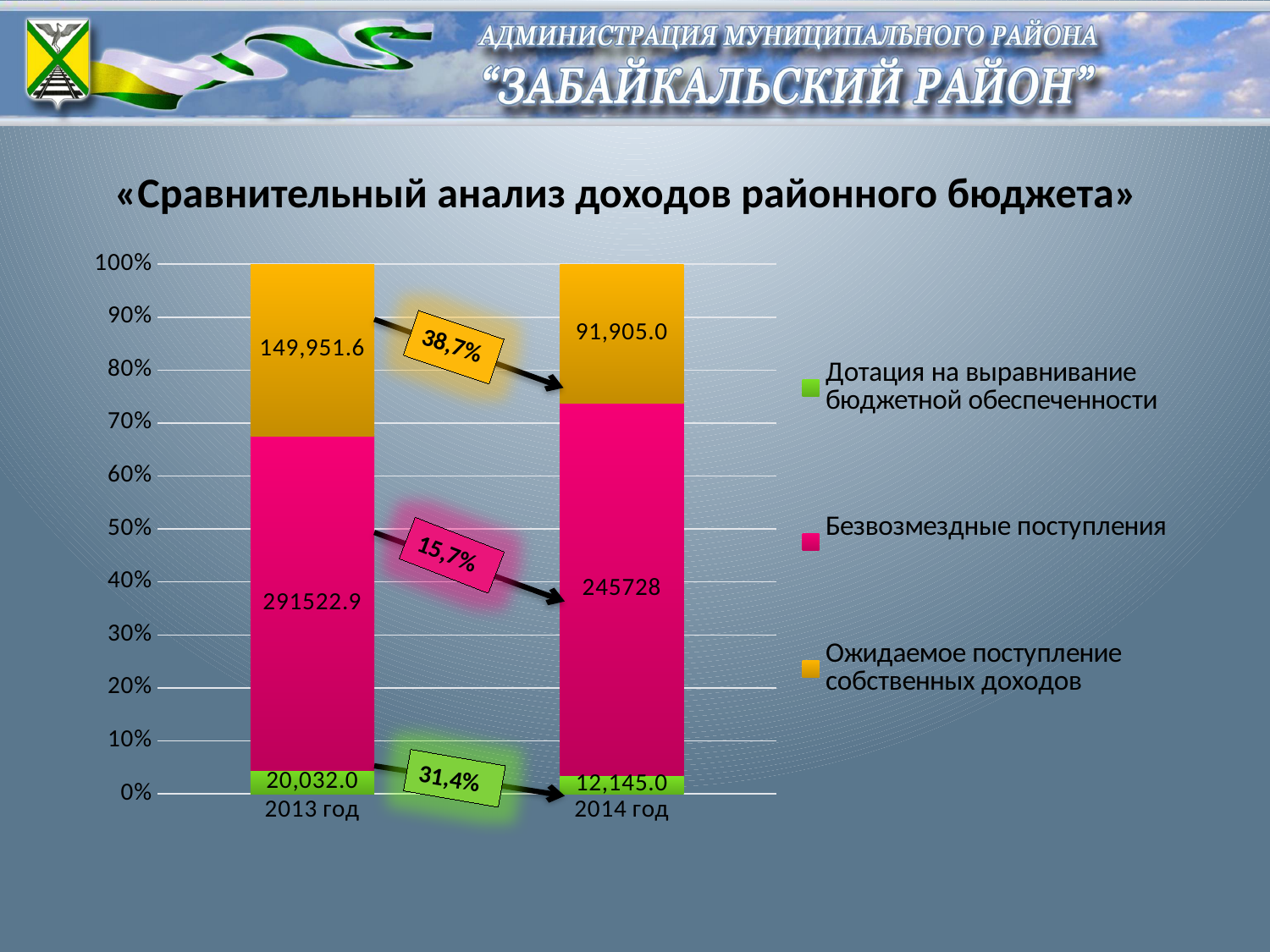
How many series does the legend list? 3 What is the value of «Ожидаемое поступление собственных доходов» for 2014 год? 91,905.0 What is the value of «Безвозмездные поступления» for 2014 год? 245728 What is the difference between the «Дотация на выравнивание бюджетной обеспеченности» values for 2013 год and 2014 год? 7,887.0 How many categories (years) are shown on the x axis? 2 What type of chart is shown on the slide? stacked bar chart What percentage change is shown on the arrow between the «Ожидаемое поступление собственных доходов» segments? 38,7% Which series has the largest value in 2013 год? Безвозмездные поступления Which series has the smallest value in 2014 год? Дотация на выравнивание бюджетной обеспеченности What is the value of «Ожидаемое поступление собственных доходов» for 2013 год? 149,951.6 Is the value of «Безвозмездные поступления» larger in 2013 год or 2014 год? 2013 год What is the value of «Дотация на выравнивание бюджетной обеспеченности» for 2013 год? 20,032.0